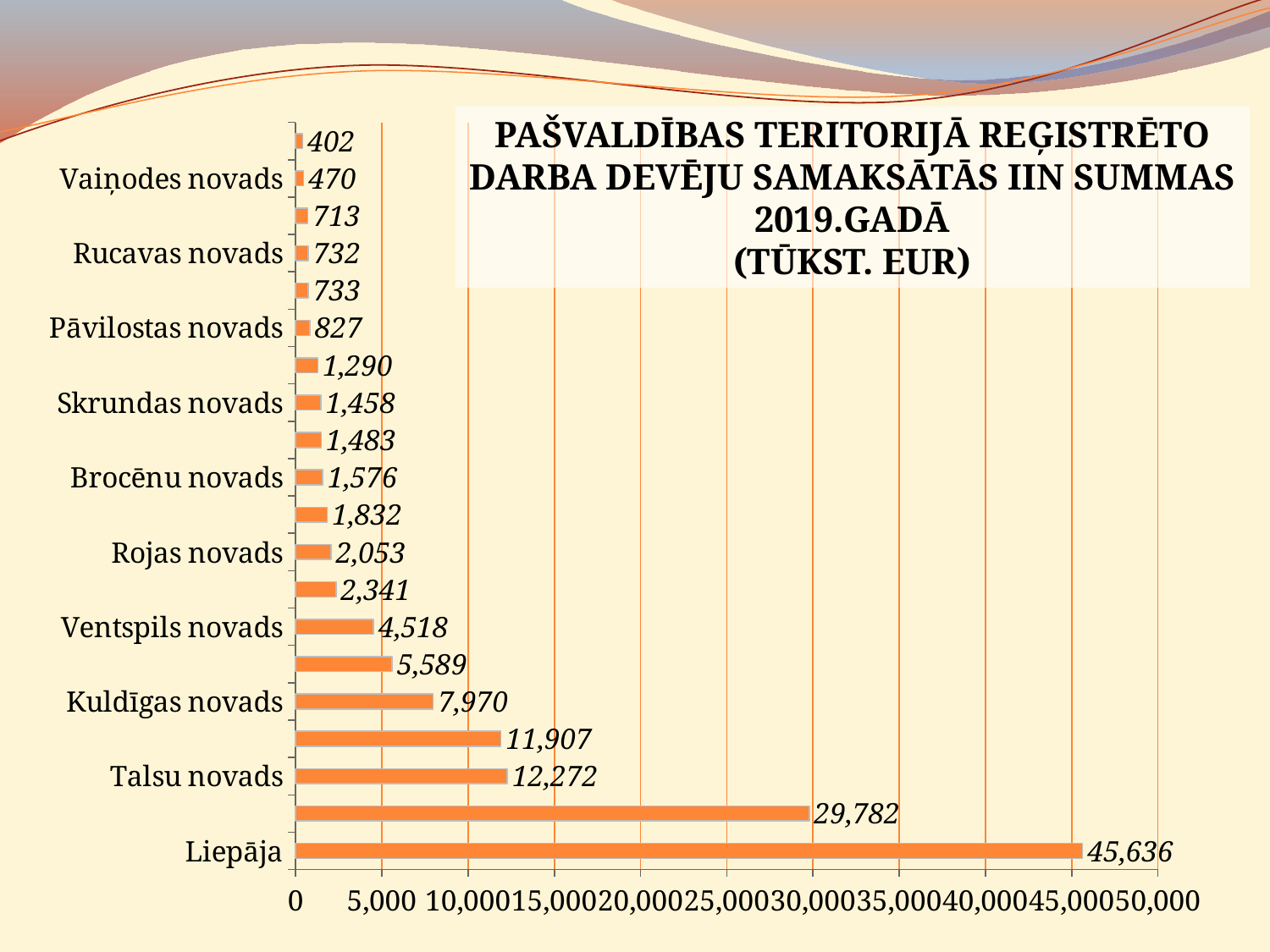
Which is larger, the value for Skrundas novads or Pāvilostas novads? Skrundas novads What is the value for Talsu novads? 12,272 What is the smallest value shown on the chart? 402 What is the value for Kuldīgas novads? 7,970 What is the value for Liepāja? 45,636 Which category has the highest value? Liepāja What is the value for Vaiņodes novads? 470 How many bars are plotted on the chart? 20 What is the value for Ventspils novads? 4,518 What is the difference between the values for Liepāja and Talsu novads? 33,364 What is the difference between the values for Kuldīgas novads and Ventspils novads? 3,452 What kind of chart is shown on the slide? Bar chart